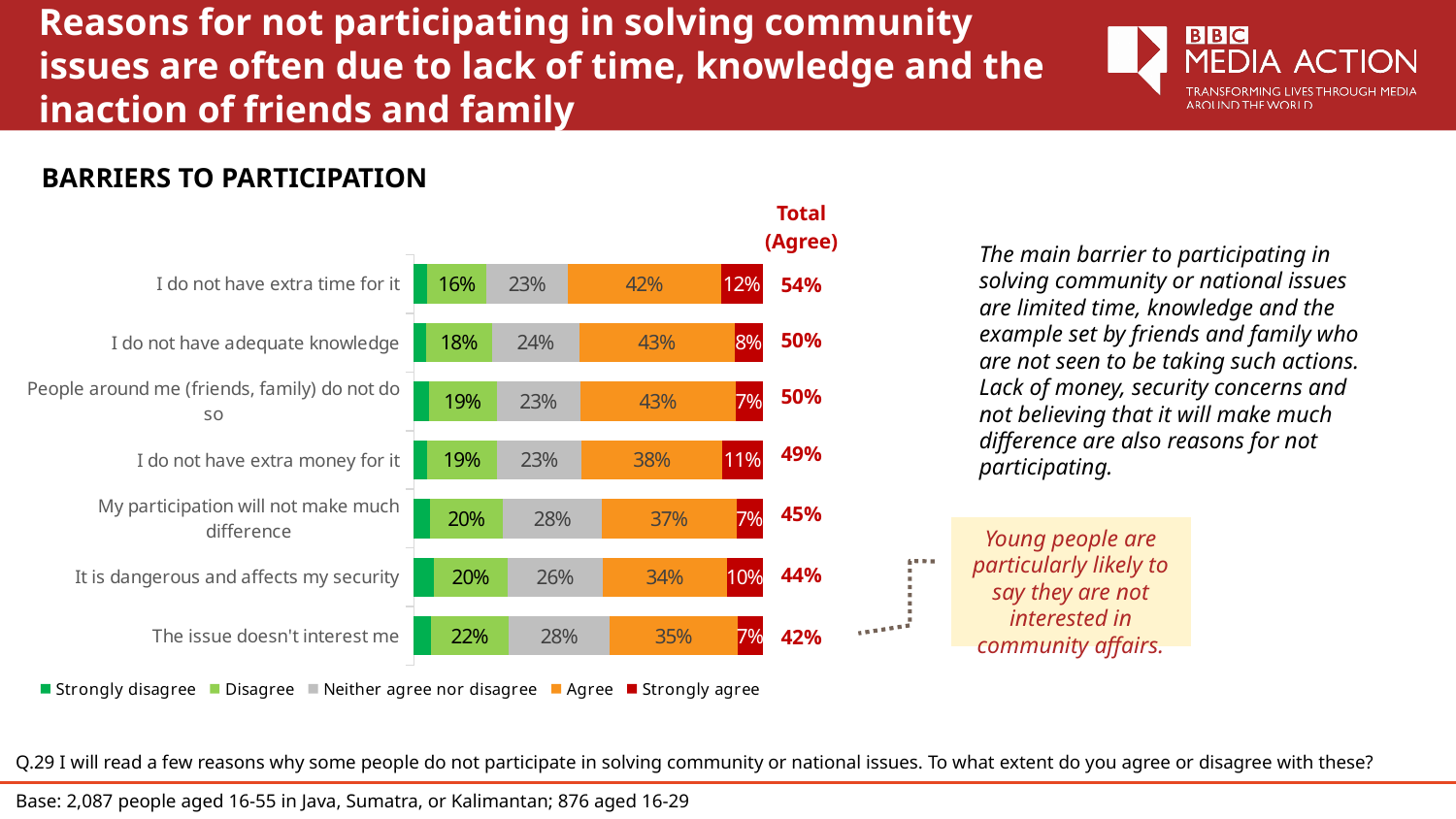
How many series does the legend list? 5 What is the title of the chart? BARRIERS TO PARTICIPATION What is the Total (Agree) figure for 'It is dangerous and affects my security'? 44% What kind of chart is shown on the slide? Stacked bar chart Which is larger: the 'Disagree' value for 'The issue doesn't interest me' or for 'I do not have extra time for it'? The issue doesn't interest me Which barrier has the lowest Total (Agree) figure? The issue doesn't interest me What is the 'Neither agree nor disagree' value for 'My participation will not make much difference'? 28% What is the 'Strongly agree' value for 'I do not have extra money for it'? 11% What is the difference between the Total (Agree) for 'I do not have extra time for it' and for 'The issue doesn't interest me'? 12% What is the 'Agree' value for 'I do not have extra time for it'? 42% How many barriers (categories) are plotted in the chart? 7 Which barrier has the highest Total (Agree) figure? I do not have extra time for it